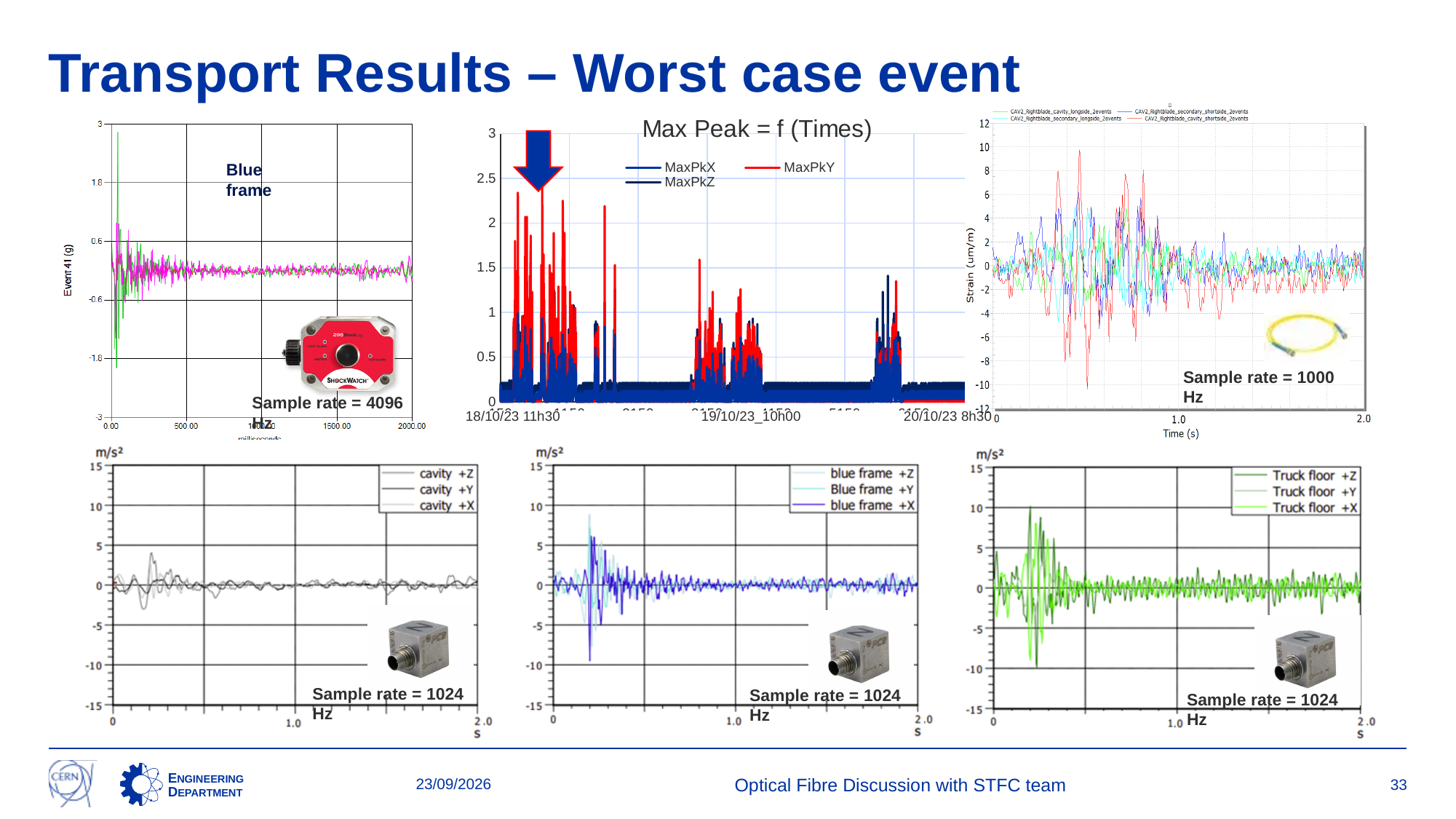
What kind of chart is the 'Max Peak = f (Times)' chart? line chart In the 'Max Peak = f (Times)' chart, is the highest MaxPkY peak greater or less than 2? greater In the bottom-middle 'blue frame' chart, is the highest peak greater or less than 5 m/s²? greater In the bottom-left 'cavity' chart, is the highest peak greater or less than 5 m/s²? less In the 'Max Peak = f (Times)' chart, how many series does the legend list? 3 In the 'Max Peak = f (Times)' chart, what are the names of the series in the legend? MaxPkX, MaxPkY, MaxPkZ In the 'Max Peak = f (Times)' chart, which series reaches the highest peak, MaxPkX or MaxPkY? MaxPkY In the 'Max Peak = f (Times)' chart, which series is drawn in red? MaxPkY In the bottom-right 'Truck floor' chart, how many series does the legend list? 3 In the top-right strain chart, how many series does the legend list? 4